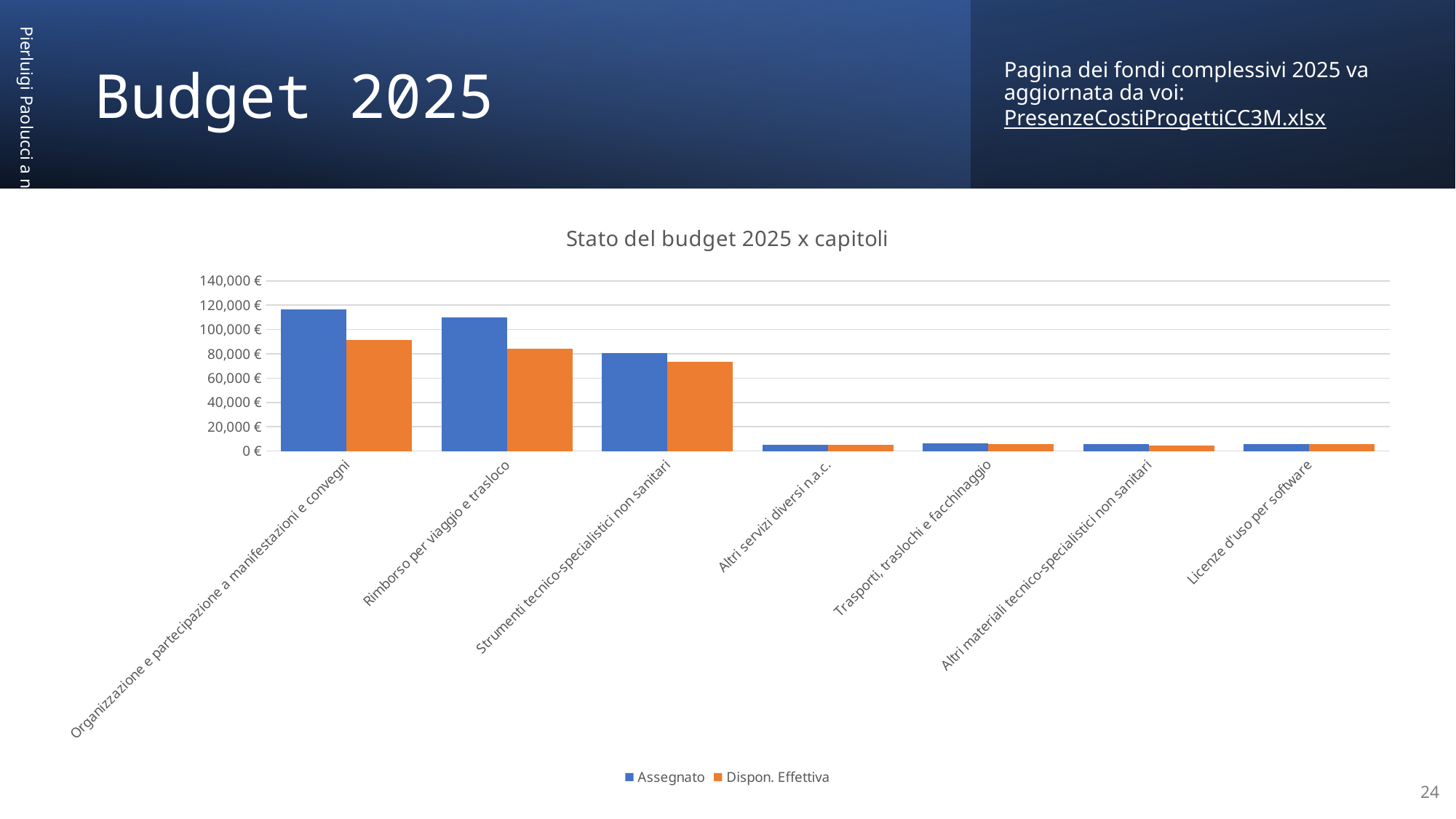
Is the Assegnato value for Organizzazione e partecipazione a manifestazioni e convegni greater or less than 100,000 €? greater Is the Dispon. Effettiva value for Rimborso per viaggio e trasloco greater or less than 100,000 €? less Do the Assegnato values generally rise or fall moving left to right along the x axis? fall How many categories are shown on the x axis of the chart? 7 For Organizzazione e partecipazione a manifestazioni e convegni, which is larger: Assegnato or Dispon. Effettiva? Assegnato Is the Assegnato value for Strumenti tecnico-specialistici non sanitari greater or less than 60,000 €? greater How many series does the chart legend list? 2 What type of chart is shown on the slide? bar chart Which category has the highest Assegnato value? Organizzazione e partecipazione a manifestazioni e convegni What are the two series named in the legend? Assegnato and Dispon. Effettiva What is the title of the chart? Stato del budget 2025 x capitoli